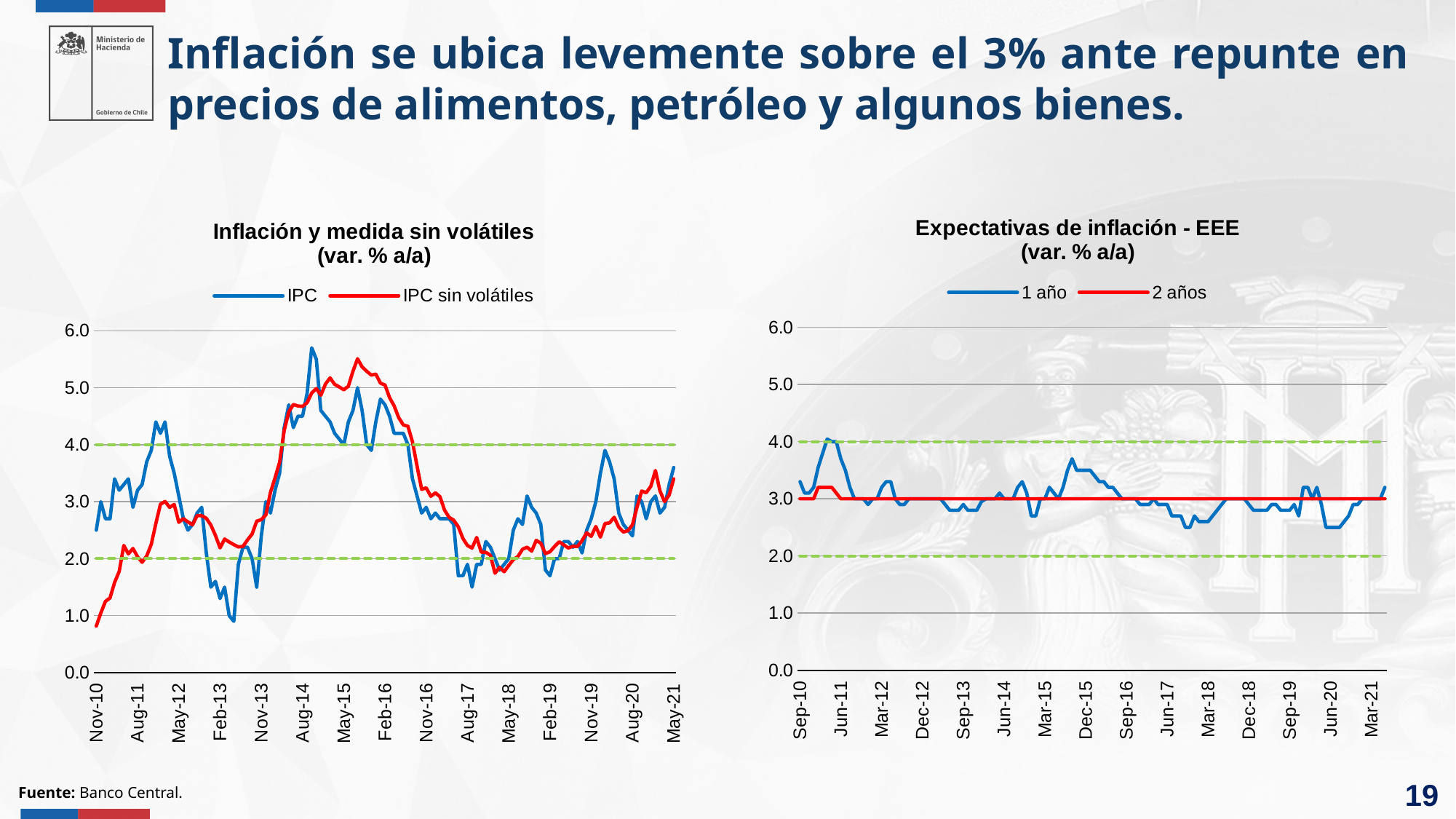
In the left chart, 'Inflación y medida sin volátiles', does the IPC line rise or fall between Nov-16 and Aug-17? fall What kind of chart is the left chart, 'Inflación y medida sin volátiles'? line chart In the right chart, 'Expectativas de inflación - EEE', what colour is the '2 años' line? red In the left chart, 'Inflación y medida sin volátiles', is the IPC sin volátiles value at Nov-10 greater or less than 1.0? less In the left chart, 'Inflación y medida sin volátiles', which series is higher at Feb-13, IPC or IPC sin volátiles? IPC sin volátiles In the right chart, 'Expectativas de inflación - EEE', does the '1 año' line rise or fall between Dec-15 and Sep-16? fall In the right chart, 'Expectativas de inflación - EEE', is the '1 año' value around Jun-20 greater or less than 3.0? less In the right chart, 'Expectativas de inflación - EEE', which series is higher at Dec-15, '1 año' or '2 años'? 1 año In the left chart, 'Inflación y medida sin volátiles', is the IPC value at its peak around Aug-14 greater or less than 5.0? greater How many series does the legend of the right chart, 'Expectativas de inflación - EEE', list? 2 In the left chart, 'Inflación y medida sin volátiles', which series is higher at Aug-14, IPC or IPC sin volátiles? IPC sin volátiles In the left chart, 'Inflación y medida sin volátiles', which two series are listed in the legend? IPC and IPC sin volátiles